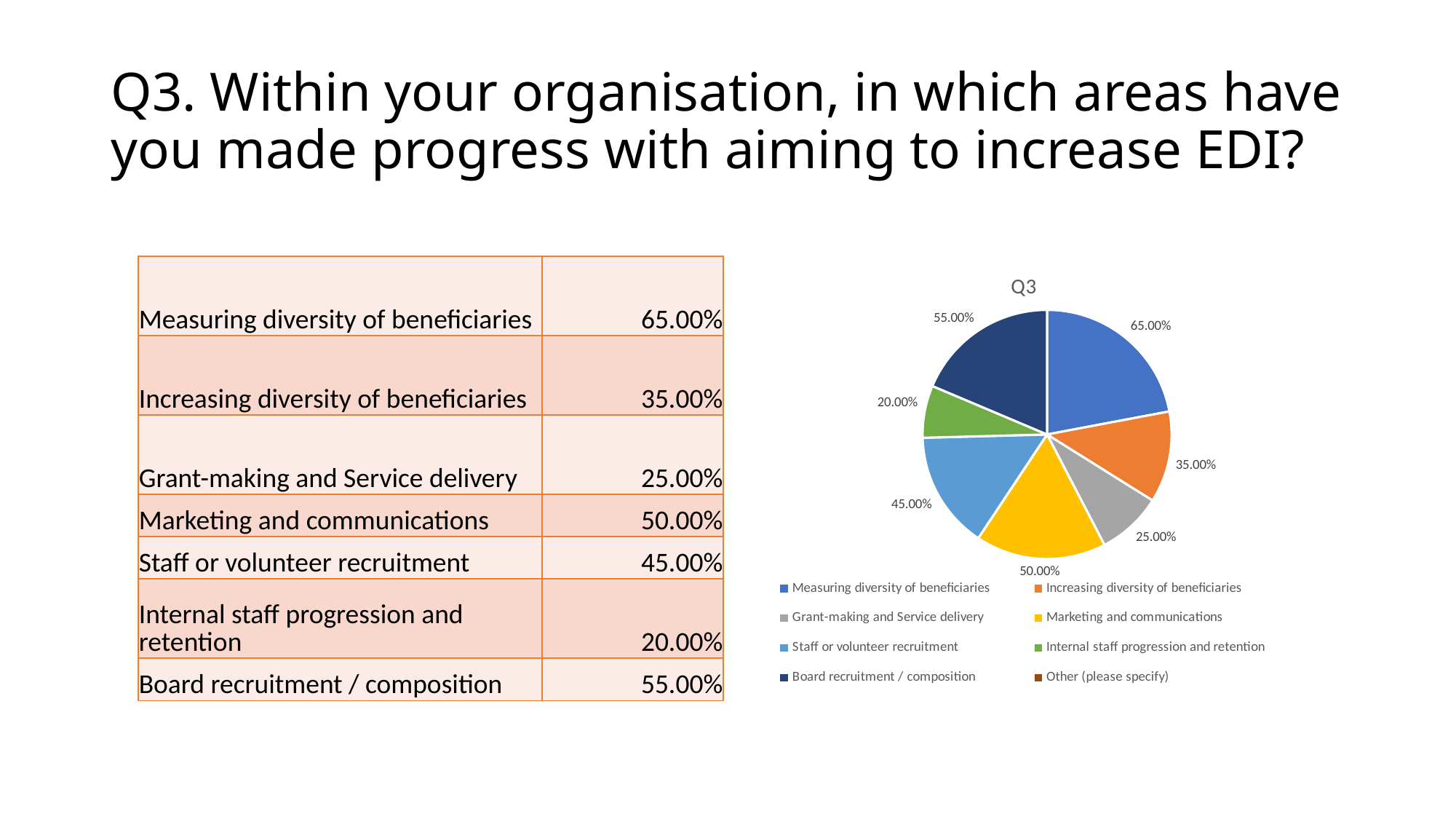
Which category has the largest slice in the pie chart? Measuring diversity of beneficiaries What value is shown for Board recruitment / composition? 55.00% Which labelled slice in the pie chart is the smallest? Internal staff progression and retention What value is shown for Grant-making and Service delivery? 25.00% What value is shown for Internal staff progression and retention? 20.00% Which is larger: Increasing diversity of beneficiaries or Grant-making and Service delivery? Increasing diversity of beneficiaries What is the difference between the values for Measuring diversity of beneficiaries and Increasing diversity of beneficiaries? 30.00% What kind of chart is shown on the slide? pie chart What value is shown for Measuring diversity of beneficiaries? 65.00% How many entries does the chart legend list? 8 What is the difference between the values for Marketing and communications and Staff or volunteer recruitment? 5.00% What is the title of the chart? Q3